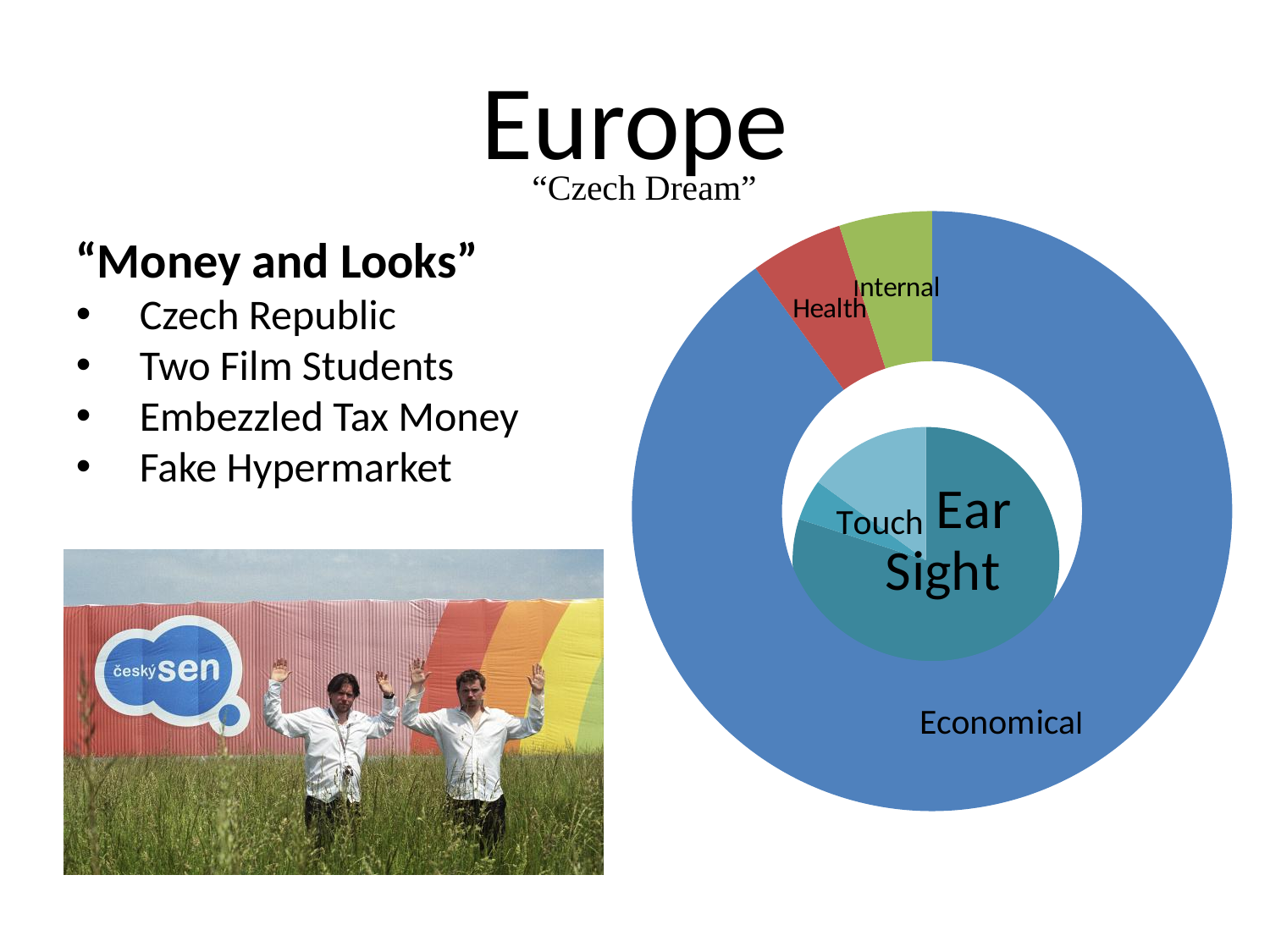
How many labelled categories are in the inner ring of the doughnut chart? 3 In the inner ring, which is larger: Ear or Touch? Ear In the inner ring, which is larger: Sight or Ear? Sight How many labelled categories are in the outer ring of the doughnut chart? 3 Which category in the inner ring of the doughnut chart is the largest? Sight What kind of chart is shown on the slide? a doughnut chart with a pie chart in its centre In the outer ring, which is larger: Economical or Health? Economical What colour is the Economical segment of the doughnut chart? blue Which category in the inner ring of the doughnut chart is the smallest? Touch What colour is the Health segment of the doughnut chart? red Which category in the outer ring of the doughnut chart is the largest? Economical